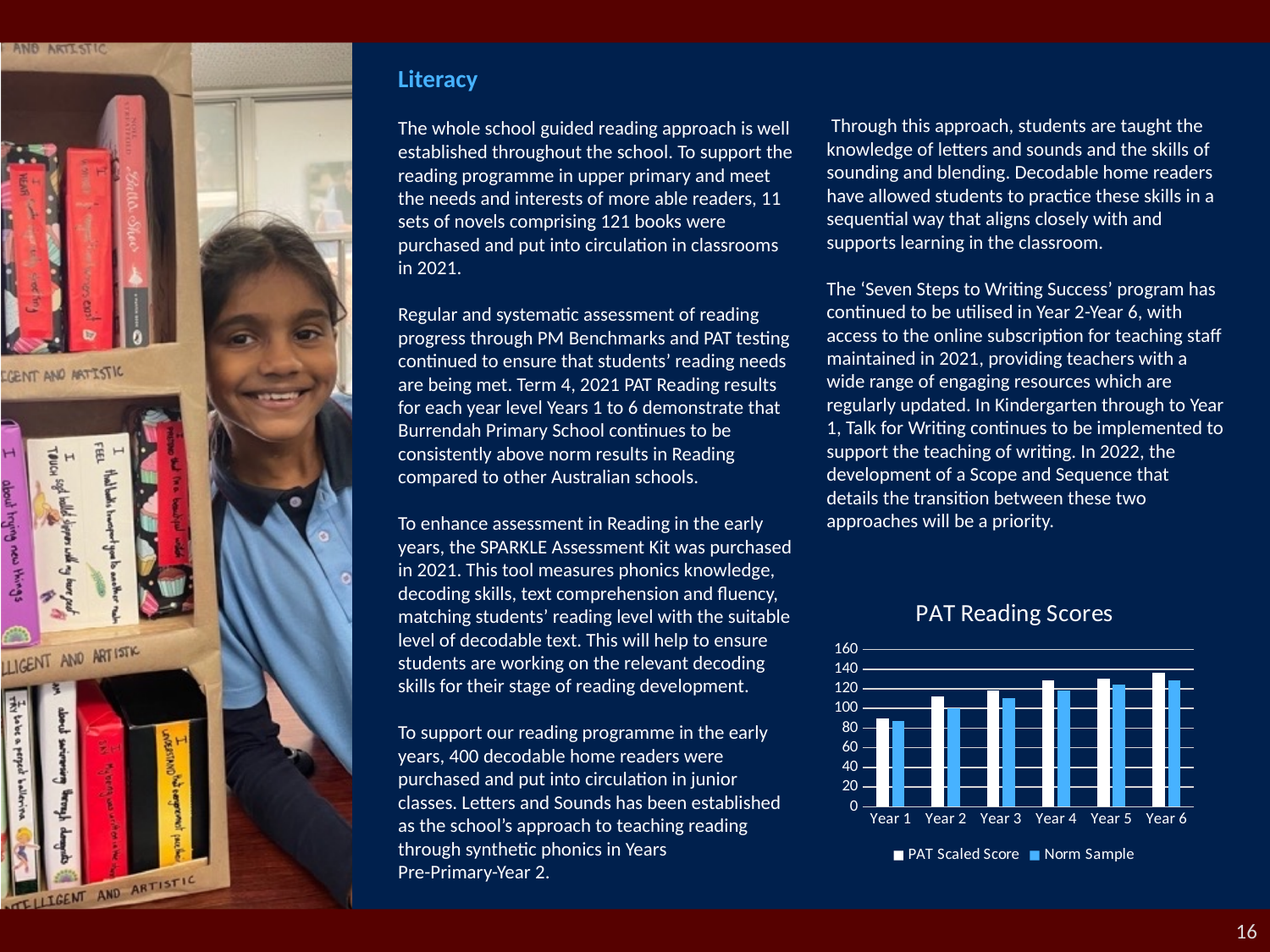
What kind of chart is the PAT Reading Scores chart? bar chart In the PAT Reading Scores chart, is the Norm Sample value for Year 4 greater or less than 100? greater How many series does the legend of the PAT Reading Scores chart list? 2 What is the title of the chart on the slide? PAT Reading Scores How many year levels are shown on the x axis of the PAT Reading Scores chart? 6 In the PAT Reading Scores chart, which year level has the highest PAT Scaled Score? Year 6 In the PAT Reading Scores chart, which year level has the lowest PAT Scaled Score? Year 1 In the PAT Reading Scores chart, do the PAT Scaled Scores generally rise or fall from Year 1 to Year 6? rise In the PAT Reading Scores chart, is the PAT Scaled Score for Year 6 greater or less than 120? greater What are the two series named in the legend of the PAT Reading Scores chart? PAT Scaled Score and Norm Sample In the PAT Reading Scores chart, is the PAT Scaled Score for Year 1 greater or less than 100? less In the PAT Reading Scores chart, which is larger for Year 2: the PAT Scaled Score or the Norm Sample? PAT Scaled Score